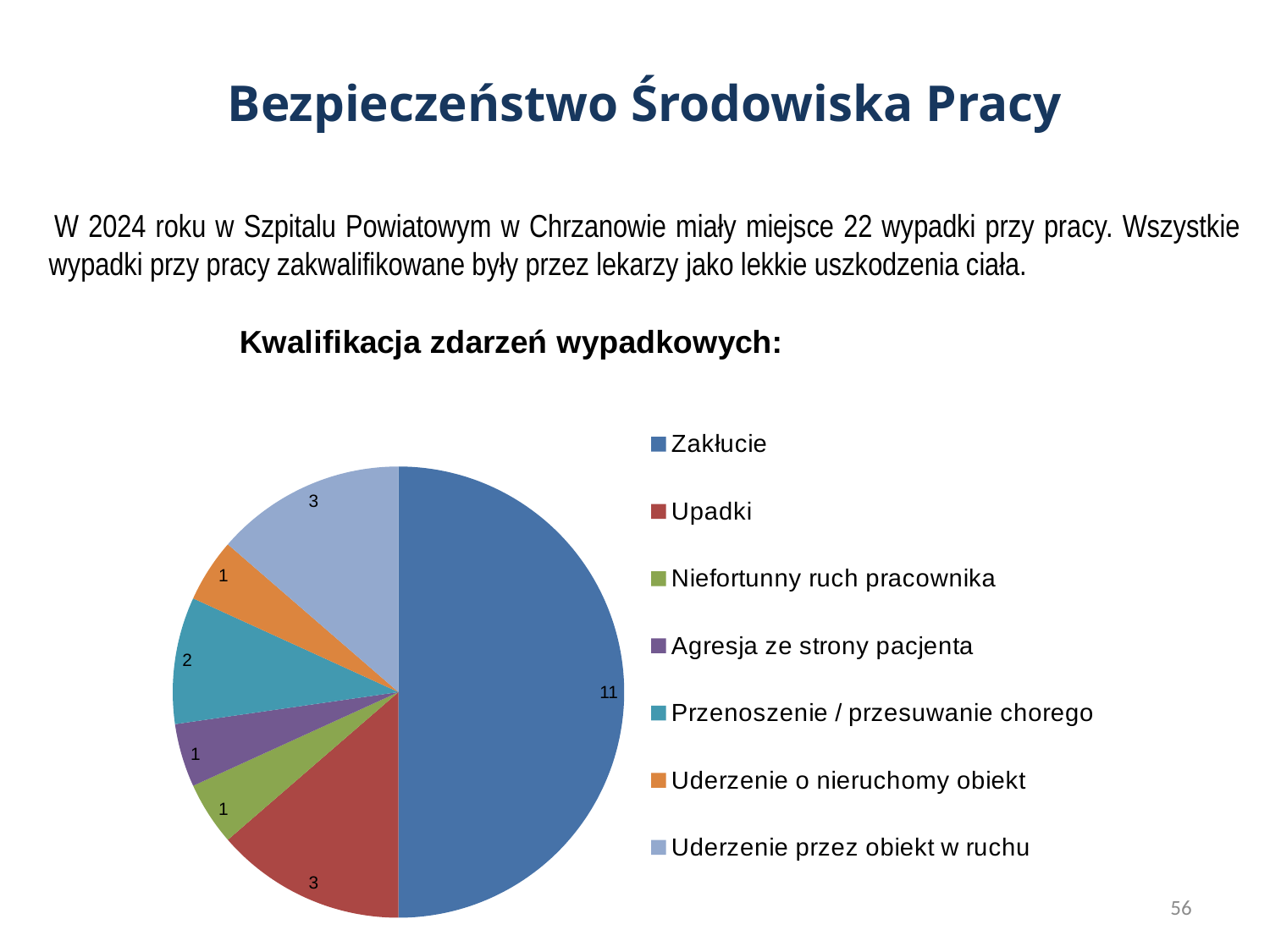
Which is larger, the value for Przenoszenie / przesuwanie chorego or the value for Uderzenie o nieruchomy obiekt? Przenoszenie / przesuwanie chorego Which category has the highest value? Zakłucie What is the difference between the values for Zakłucie and Upadki? 8 How many categories does the pie chart have? 7 What is the title of the chart? Kwalifikacja zdarzeń wypadkowych: What share of the pie does Zakłucie represent? 50% What is the value for Agresja ze strony pacjenta? 1 What is the value for Przenoszenie / przesuwanie chorego? 2 What is the value for Upadki? 3 What is the value for Uderzenie przez obiekt w ruchu? 3 What kind of chart is shown on the slide? pie chart What is the value for Zakłucie? 11